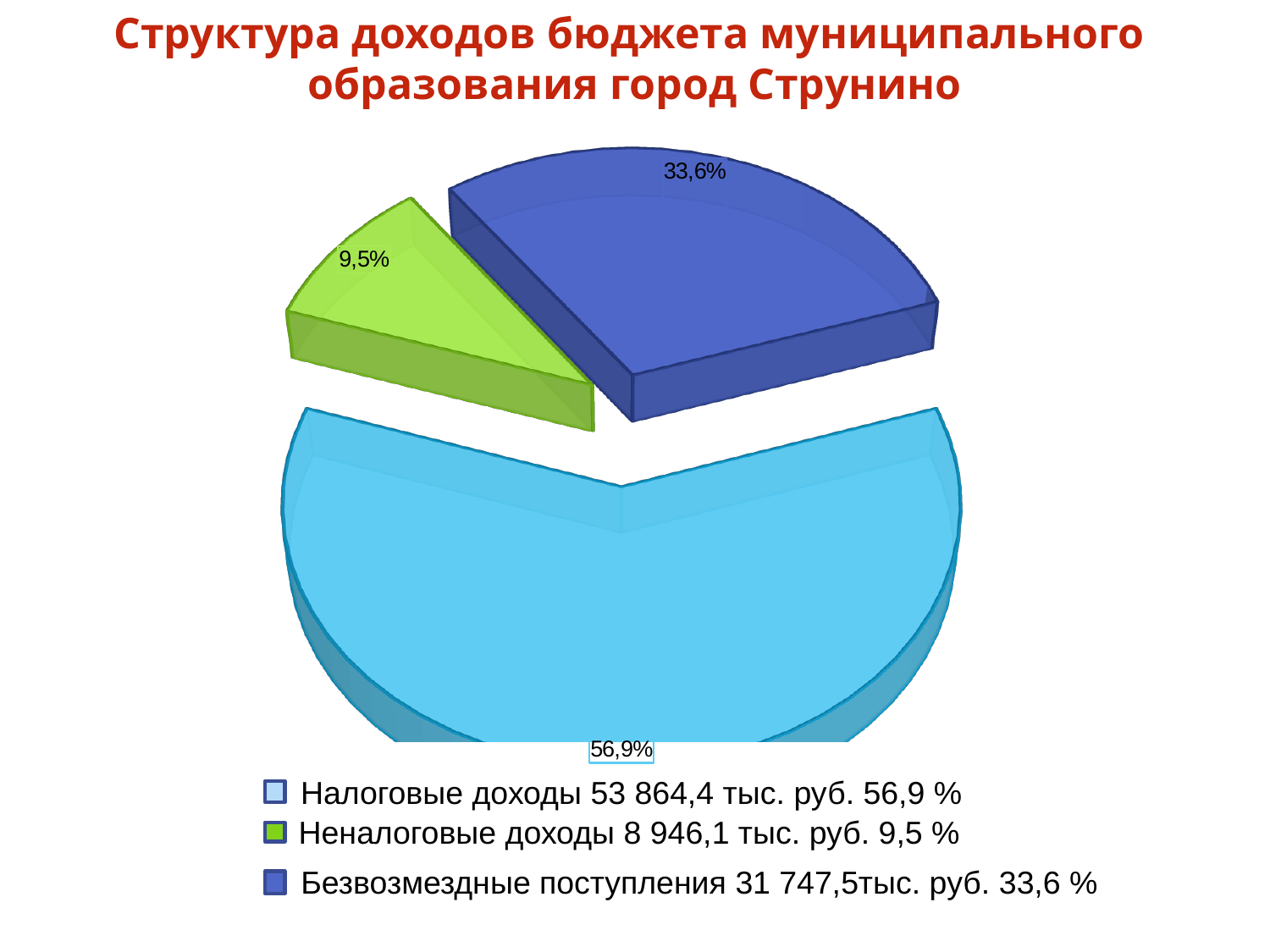
Which category has the smallest share of the pie? Неналоговые доходы What share of the pie does Безвозмездные поступления take? 33,6% What share of the pie does Неналоговые доходы take? 9,5% What colour is the slice for Неналоговые доходы? green According to the legend, what is the amount of Налоговые доходы in тыс. руб.? 53 864,4 тыс. руб. Which category has the largest share of the pie? Налоговые доходы Which is larger: the share of Безвозмездные поступления or the share of Неналоговые доходы? Безвозмездные поступления What is the difference in percentage points between the shares of Налоговые доходы and Безвозмездные поступления? 23,3 How many slices does the pie chart have? 3 What share of the pie does Налоговые доходы take? 56,9% What kind of chart is shown on the slide? pie chart According to the legend, what is the amount of Безвозмездные поступления in тыс. руб.? 31 747,5 тыс. руб.